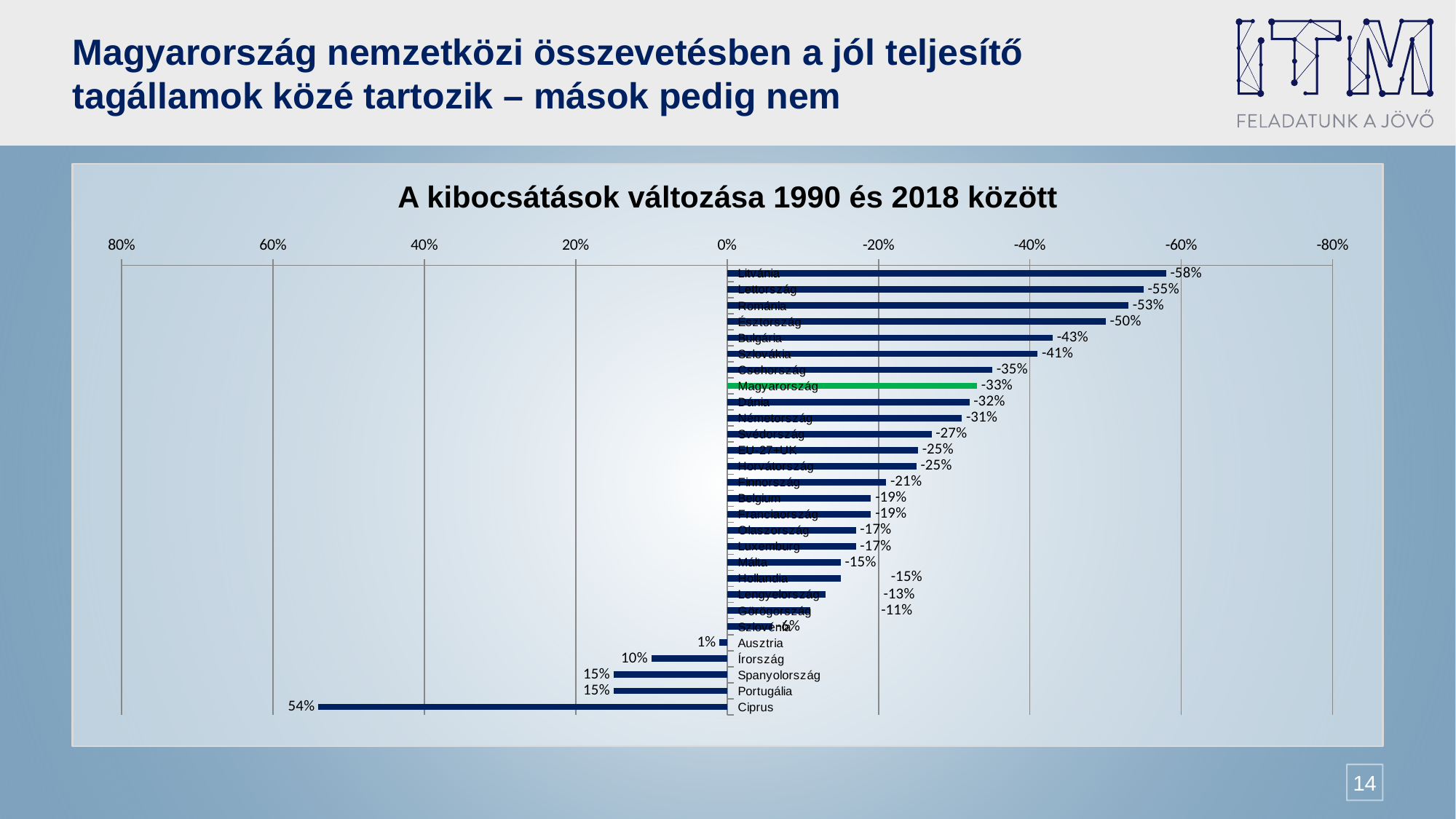
Which has a larger decrease in emissions, Bulgária or Szlovákia? Bulgária Which country's bar is highlighted in green? Magyarország What kind of chart is shown on the slide? Bar chart How many countries/categories are plotted in the chart? 28 What is the value shown for Litvánia? -58% What is the title of the chart? A kibocsátások változása 1990 és 2018 között Which country shows the largest increase in emissions (the highest positive value)? Ciprus Which country shows the largest decrease in emissions (the most negative value)? Litvánia What is the difference in percentage points between the values for Litvánia (-58%) and Magyarország (-33%)? 25 percentage points What is the value shown for Írország? 10% What is the value shown for Ciprus? 54% What is the value shown for Magyarország? -33%